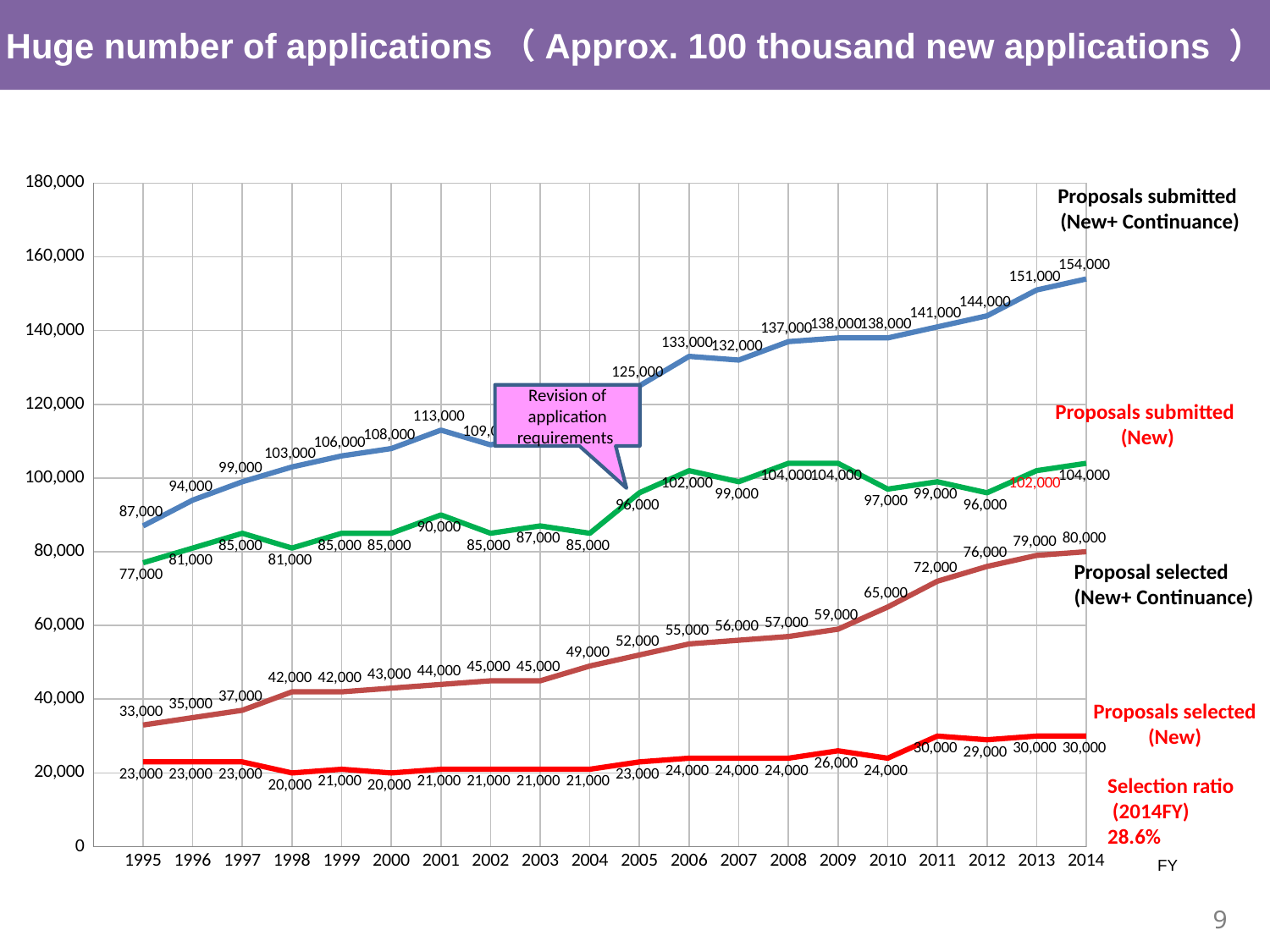
Which is larger in FY2005: Proposals submitted (New) or Proposal selected (New+ Continuance)? Proposals submitted (New) What is the value of Proposals selected (New) in FY2009? 26,000 What is the difference between Proposals submitted (New+ Continuance) and Proposals submitted (New) in FY2014? 50,000 In which fiscal year is Proposals submitted (New+ Continuance) highest? 2014 What is the value of Proposals submitted (New) in FY1995? 77,000 What kind of chart is shown on the slide? Line chart How many fiscal years are plotted on the x axis? 20 What is the value of Proposals submitted (New+ Continuance) in FY2014? 154,000 What is the value of Proposal selected (New+ Continuance) in FY2011? 72,000 Is the value of Proposals submitted (New+ Continuance) in FY2003 greater or less than 100,000? greater In which fiscal year is Proposals submitted (New) lowest? 1995 What is the selection ratio for 2014FY shown on the slide? 28.6%